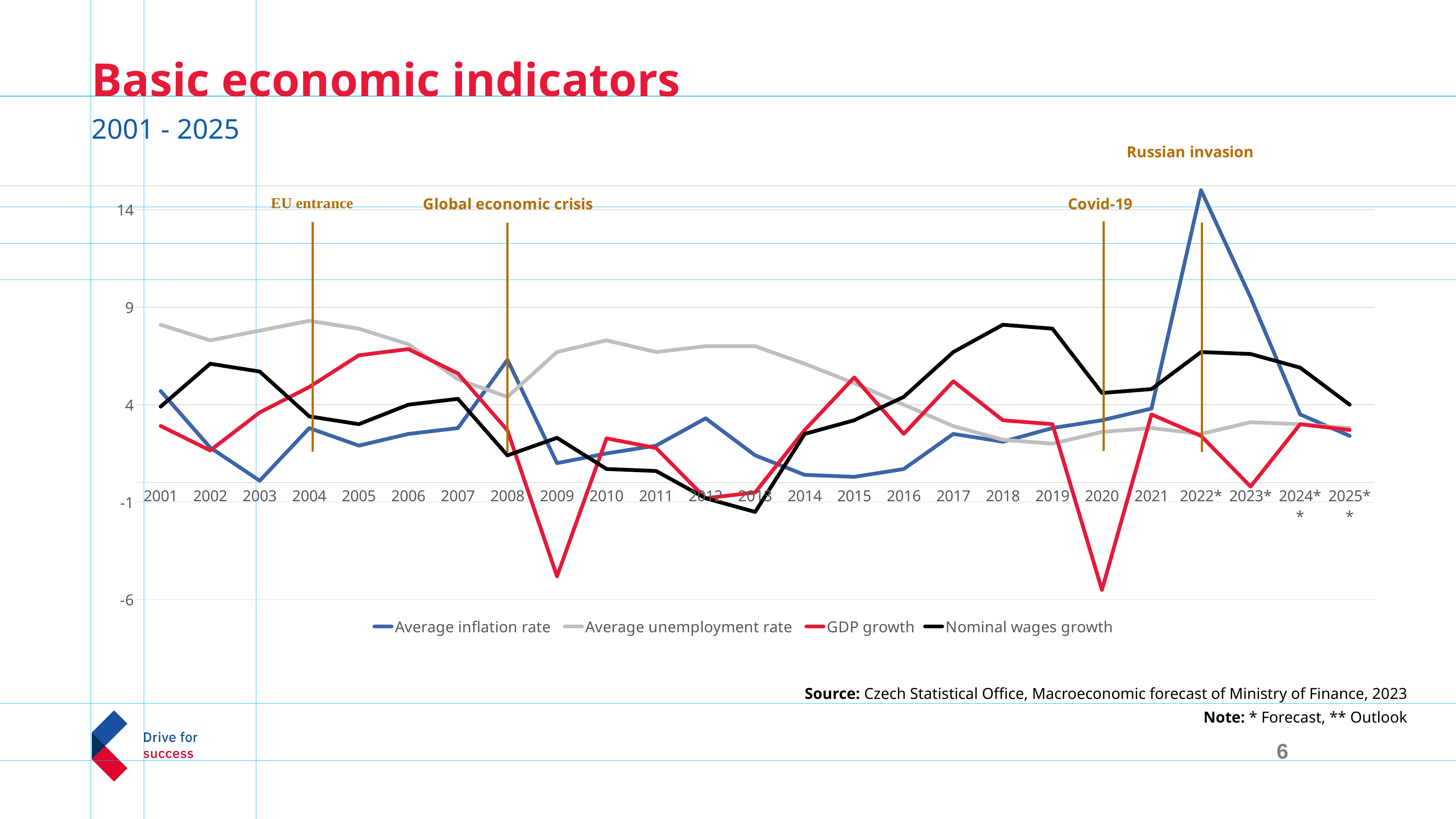
How many years are plotted along the x axis? 25 Is the Average inflation rate in 2022* greater or less than 14? greater Which event is marked on the chart at 2020? Covid-19 In which year does the Average inflation rate reach its highest value? 2022* In which year is GDP growth at its lowest? 2020 What kind of chart is shown on the slide? line chart Is GDP growth in 2009 greater or less than -1? less What colour is the GDP growth line? red How many series does the legend list? 4 Does the Average unemployment rate rise or fall between 2004 and 2008? fall In 2018, which is higher: Nominal wages growth or Average inflation rate? Nominal wages growth Is the Average unemployment rate in 2004 greater or less than 4? greater